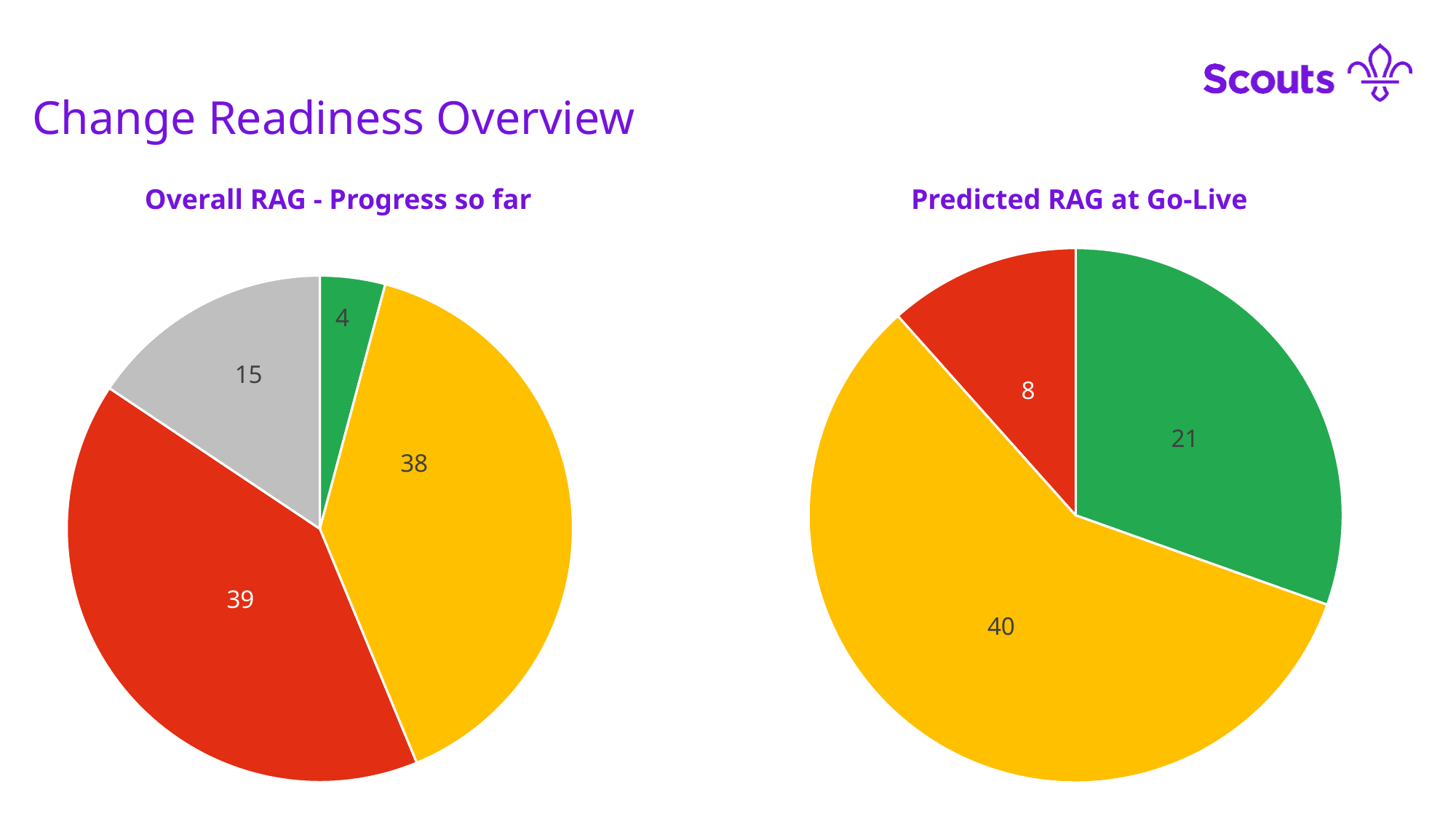
In the 'Predicted RAG at Go-Live' chart, which colour slice has the largest value? Yellow In the 'Overall RAG - Progress so far' chart, what is the value of the grey slice? 15 In the 'Overall RAG - Progress so far' chart, what is the value of the red slice? 39 What type of chart is used for 'Overall RAG - Progress so far'? Pie chart In the 'Predicted RAG at Go-Live' chart, how many slices are there? 3 In the 'Predicted RAG at Go-Live' chart, what is the value of the green slice? 21 In the 'Overall RAG - Progress so far' chart, how many slices are there? 4 In the 'Predicted RAG at Go-Live' chart, what is the difference between the yellow slice and the red slice? 32 In the 'Overall RAG - Progress so far' chart, what is the difference between the yellow slice and the grey slice? 23 What is the title of the chart on the right side of the slide? Predicted RAG at Go-Live In the 'Overall RAG - Progress so far' chart, which colour slice has the smallest value? Green In the 'Predicted RAG at Go-Live' chart, is the green slice or the red slice larger? Green